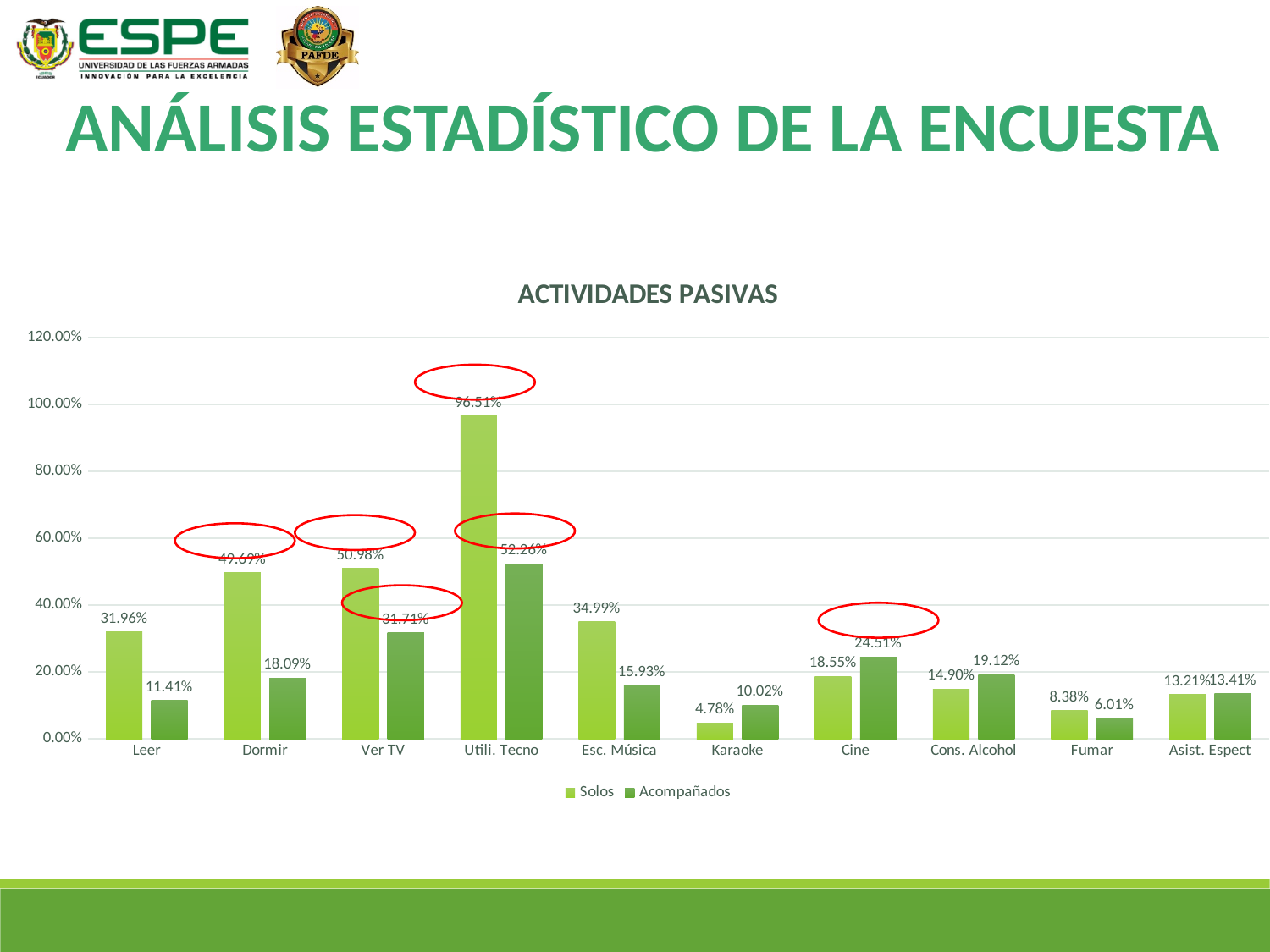
For Karaoke, which is larger: the Solos value or the Acompañados value? Acompañados What type of chart is shown on the slide? Bar chart Which category has the highest Solos value? Utili. Tecno What is the Solos value for Karaoke? 4.78% What is the Solos value for Leer? 31.96% What is the Acompañados value for Esc. Música? 15.93% How many series does the legend of the ACTIVIDADES PASIVAS chart list? 2 What is the difference between the Solos and Acompañados values for Leer? 20.55% How many activity categories are shown on the x axis of the chart? 10 What is the Acompañados value for Cons. Alcohol? 19.12% Which category has the lowest Acompañados value? Fumar Is the Solos value for Utili. Tecno greater or less than 80.00%? greater